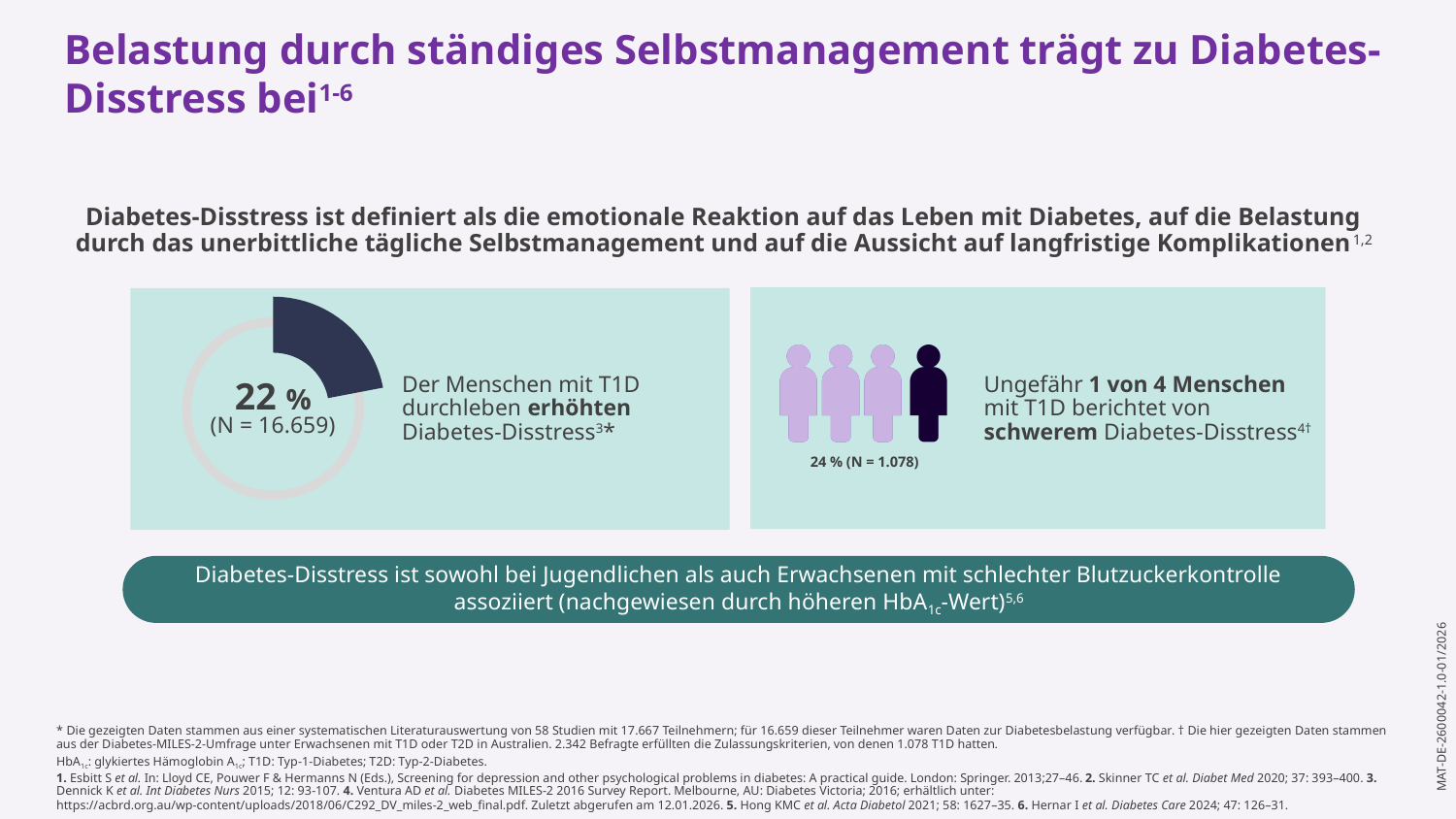
In the right chart, how many of the person icons are highlighted in dark colour? 1 In the left chart, what colour is the highlighted 22 % segment of the donut? Dark navy/purple In the left chart (donut), what percentage of people with T1D experience elevated diabetes distress? 22 % In the right chart, how many person icons are shown in total? 4 In the left chart, is the highlighted share greater or less than 25 %? less In the right chart (person icons), what sample size (N) is given below the icons? N = 1.078 Which value is larger: the 22 % in the left chart or the 24 % in the right chart? 24 % (right chart) In the right chart (person icons), what percentage of people with T1D report severe diabetes distress? 24 % In the right chart, what ratio of people with T1D does the highlighted icon represent according to the text beside it? 1 von 4 What is the difference in percentage points between the right chart's 24 % and the left chart's 22 %? 2 percentage points What kind of chart is shown on the left side of the slide? Donut (pie) chart In the left chart (donut), what sample size (N) is shown in the centre? N = 16.659